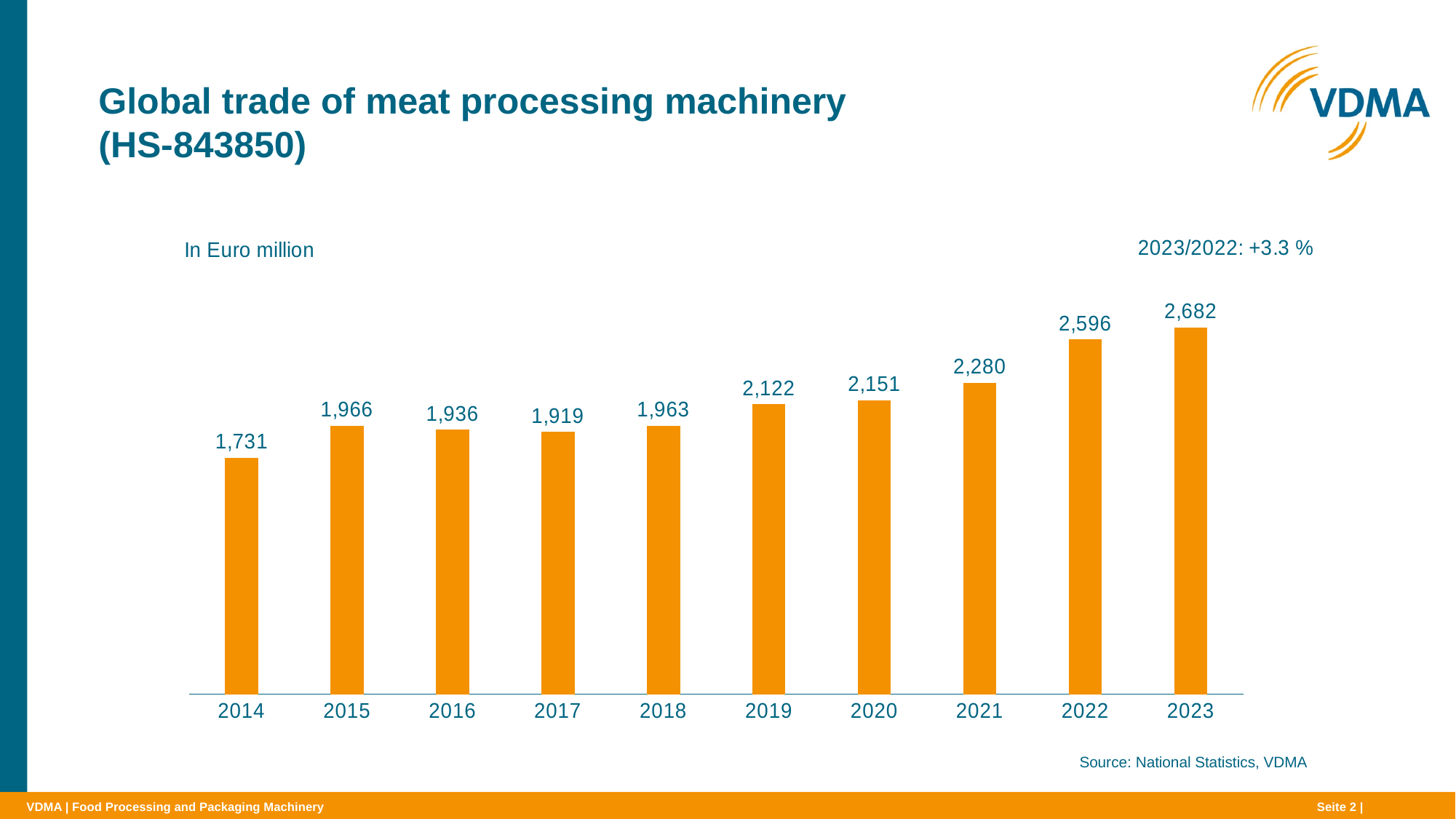
What is the difference between the values for 2021 and 2020? 129 Do the values generally rise or fall from 2018 to 2023? Rise What is the value for 2014? 1,731 Which is larger, the value for 2015 or the value for 2017? 2015 What is the difference between the values for 2023 and 2022? 86 In what unit are the values given? Euro million What is the value for 2023? 2,682 How many years are shown on the x axis? 10 Which year has the lowest value? 2014 What kind of chart is shown on the slide? Bar chart Which year has the highest value? 2023 What is the value for 2019? 2,122